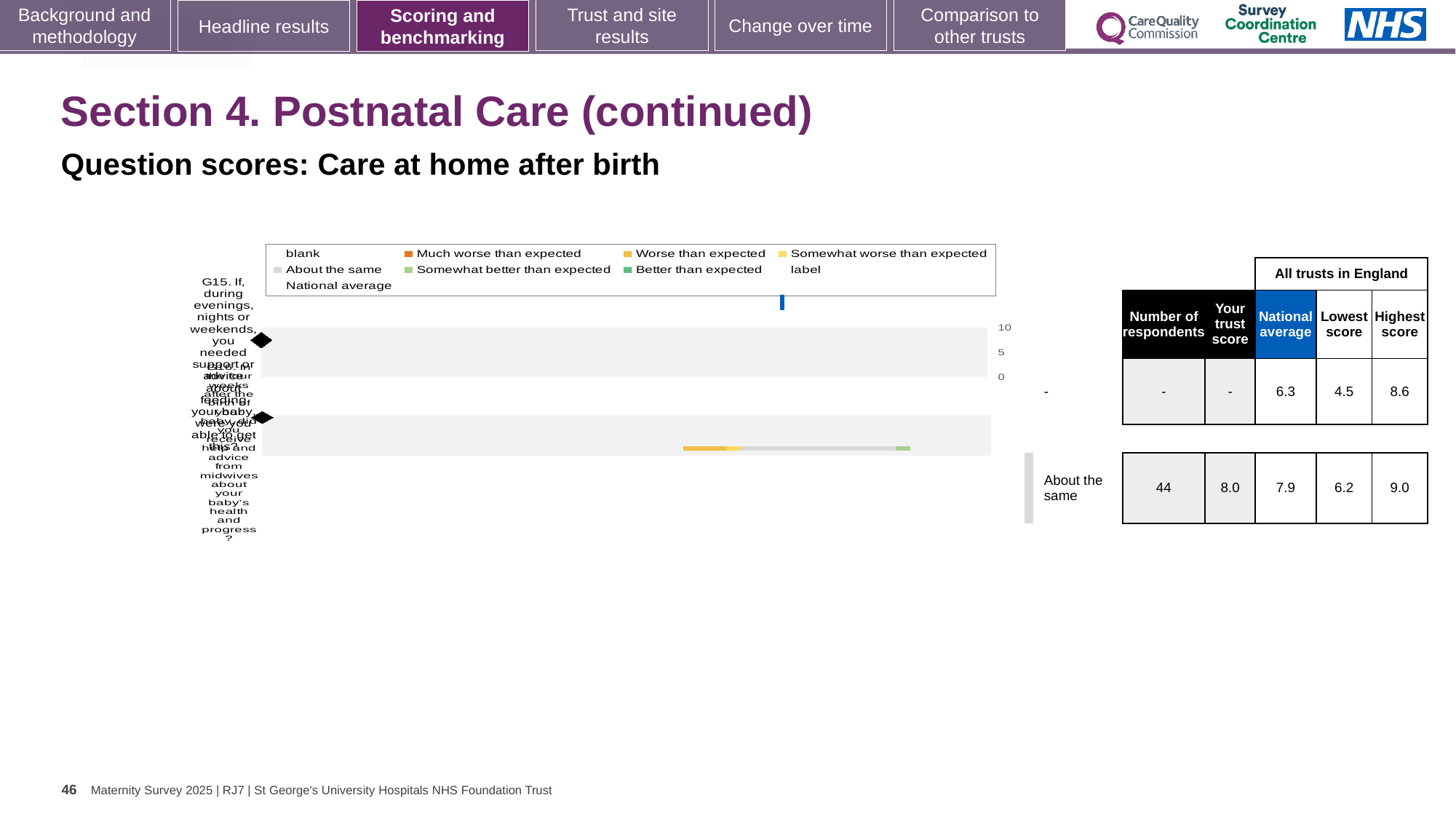
In the table beside the chart, what is the highest score for the 'About the same' row? 9.0 In the table beside the chart, what is the difference between the highest score and the lowest score in the 'About the same' row? 2.8 In the table beside the chart, what is the trust score for the 'About the same' row? 8.0 What kind of chart is shown on the slide? bar chart In the table beside the chart, what is the difference between the highest score and the lowest score in the first row? 4.1 How many entries does the chart legend list? 9 What colour does the legend use for 'Better than expected'? green In the table beside the chart, what is the number of respondents for the 'About the same' row? 44 In the table beside the chart, what is the national average for the 'About the same' row? 7.9 In the table beside the chart, what is the lowest score in the first row? 4.5 What colour does the legend use for 'Much worse than expected'? orange In the table beside the chart, which is larger for the 'About the same' row: the trust score or the national average? trust score